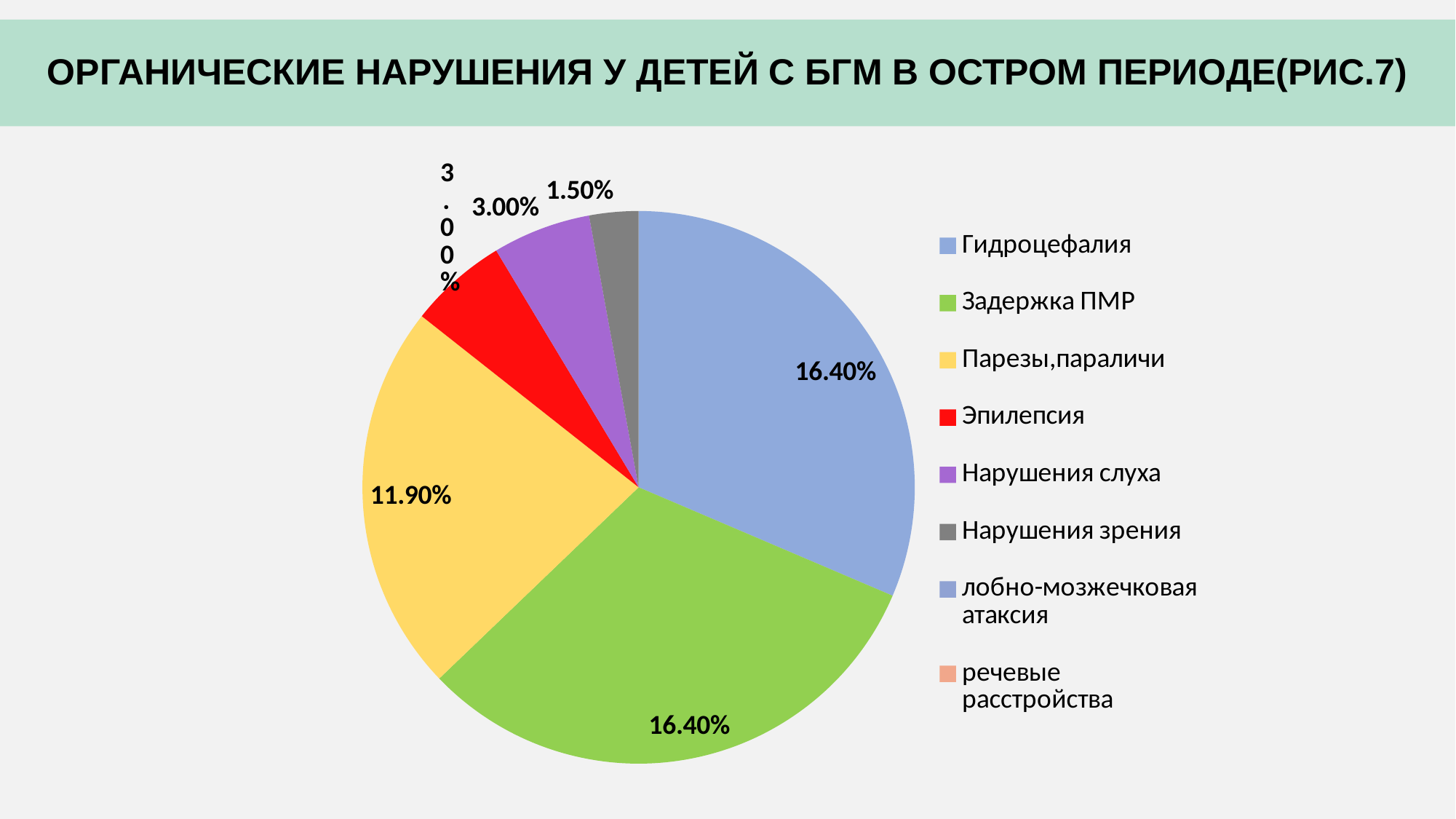
What is the value shown for Задержка ПМР? 16.40% How many entries does the legend list? 8 What type of chart is shown on the slide? pie chart What is the value shown for Парезы,параличи? 11.90% Which is larger, the value for Парезы,параличи or the value for Эпилепсия? Парезы,параличи What colour is the slice for Эпилепсия? red What is the title of the slide? ОРГАНИЧЕСКИЕ НАРУШЕНИЯ У ДЕТЕЙ С БГМ В ОСТРОМ ПЕРИОДЕ(РИС.7) What is the value shown for Нарушения слуха? 3.00% What is the value shown for Нарушения зрения? 1.50% What is the value shown for Гидроцефалия? 16.40% What is the difference between the values for Гидроцефалия and Парезы,параличи? 4.50% Which labelled category has the lowest value? Нарушения зрения